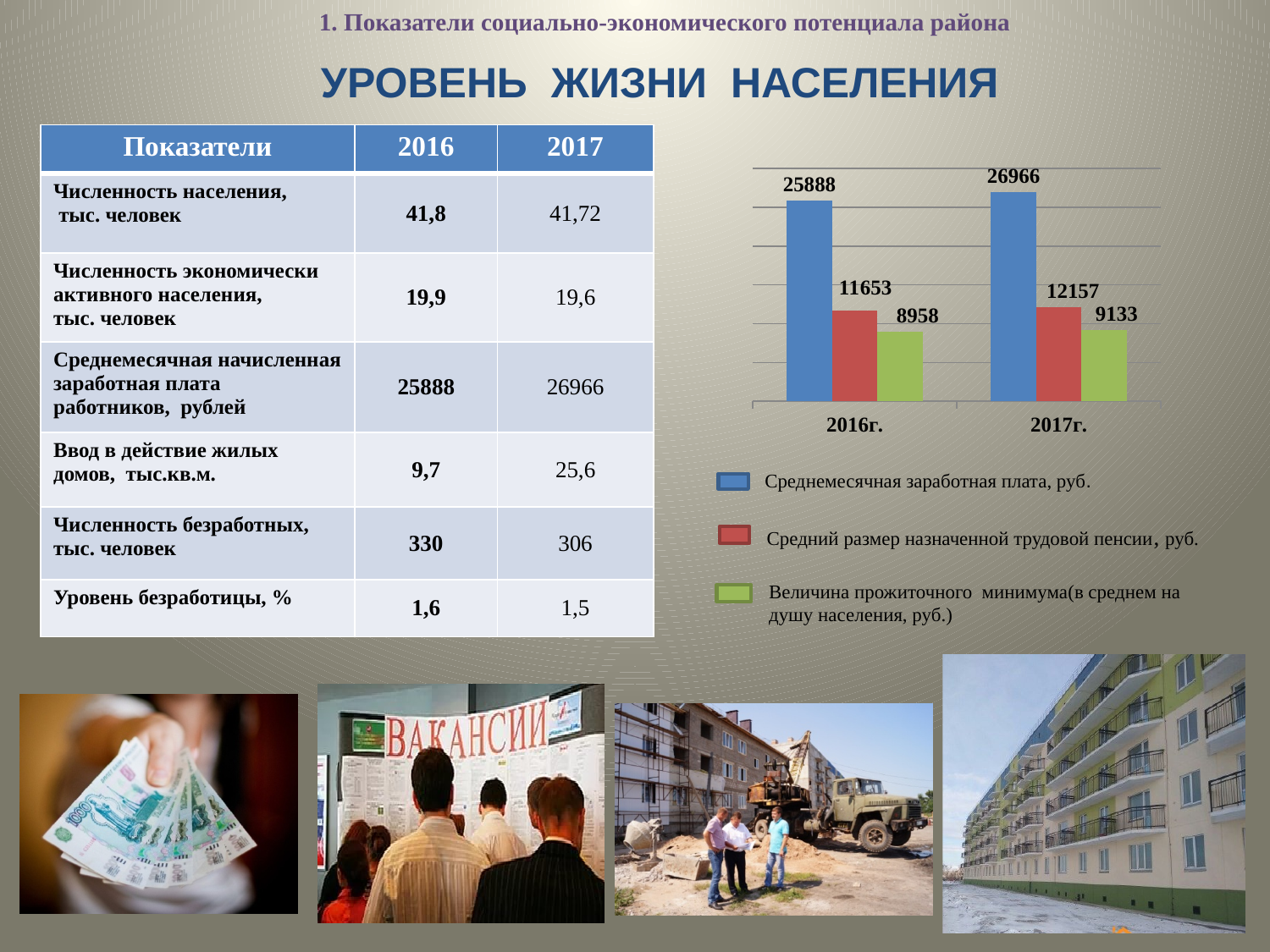
In the chart, which is larger for 2016г.: the average pension or the subsistence minimum? the average pension (11653) What type of chart is shown on the slide? bar chart How many series does the chart's legend list? 3 What is the average monthly wage (Среднемесячная заработная плата) shown in the chart for 2017г.? 26966 What is the average assigned labour pension (Средний размер назначенной трудовой пенсии) shown in the chart for 2016г.? 11653 What is the average monthly wage (Среднемесячная заработная плата) shown in the chart for 2016г.? 25888 Does the subsistence minimum in the chart rise or fall from 2016г. to 2017г.? rise Which series has the highest value in the chart for 2017г.? Среднемесячная заработная плата, руб. What is the subsistence minimum (Величина прожиточного минимума) shown in the chart for 2017г.? 9133 Which series has the lowest value in the chart for 2016г.? Величина прожиточного минимума What is the difference between the average pension and the subsistence minimum in the chart for 2017г.? 3024 By how much did the average monthly wage in the chart increase from 2016г. to 2017г.? 1078